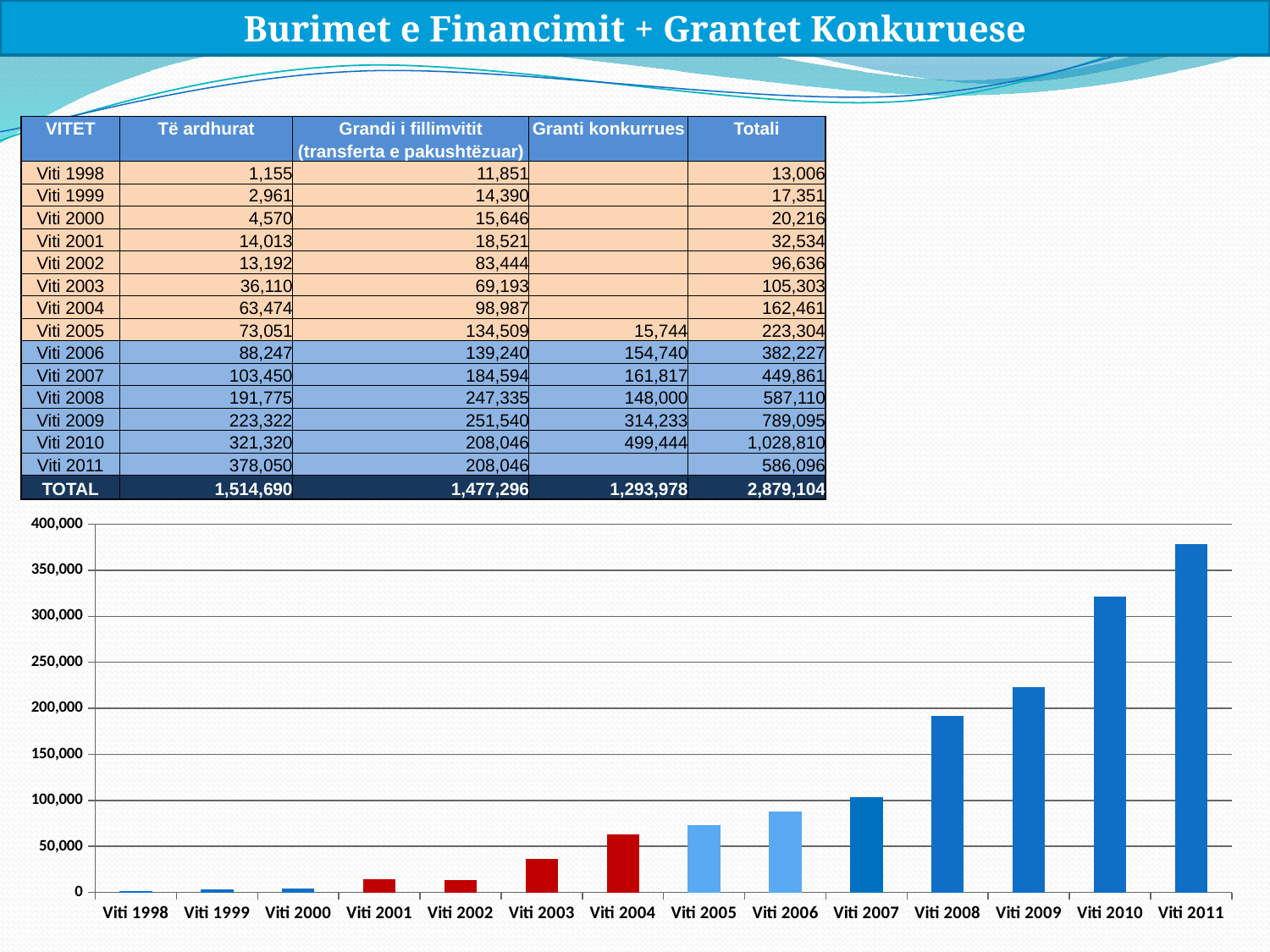
Which year has the shortest bar on the chart? Viti 1998 What is the highest value shown on the chart's vertical axis? 400,000 Which bar is taller, Viti 2009 or Viti 2010? Viti 2010 Which year has the tallest bar on the chart? Viti 2011 Is the bar for Viti 2010 greater or less than 300,000? greater What kind of chart is shown at the bottom of the slide? bar chart Is the bar for Viti 2011 greater or less than 350,000? greater How many years (bars) are plotted on the chart? 14 Is the bar for Viti 2008 greater or less than 200,000? less Do the bar values generally rise or fall from Viti 1998 to Viti 2011? rise